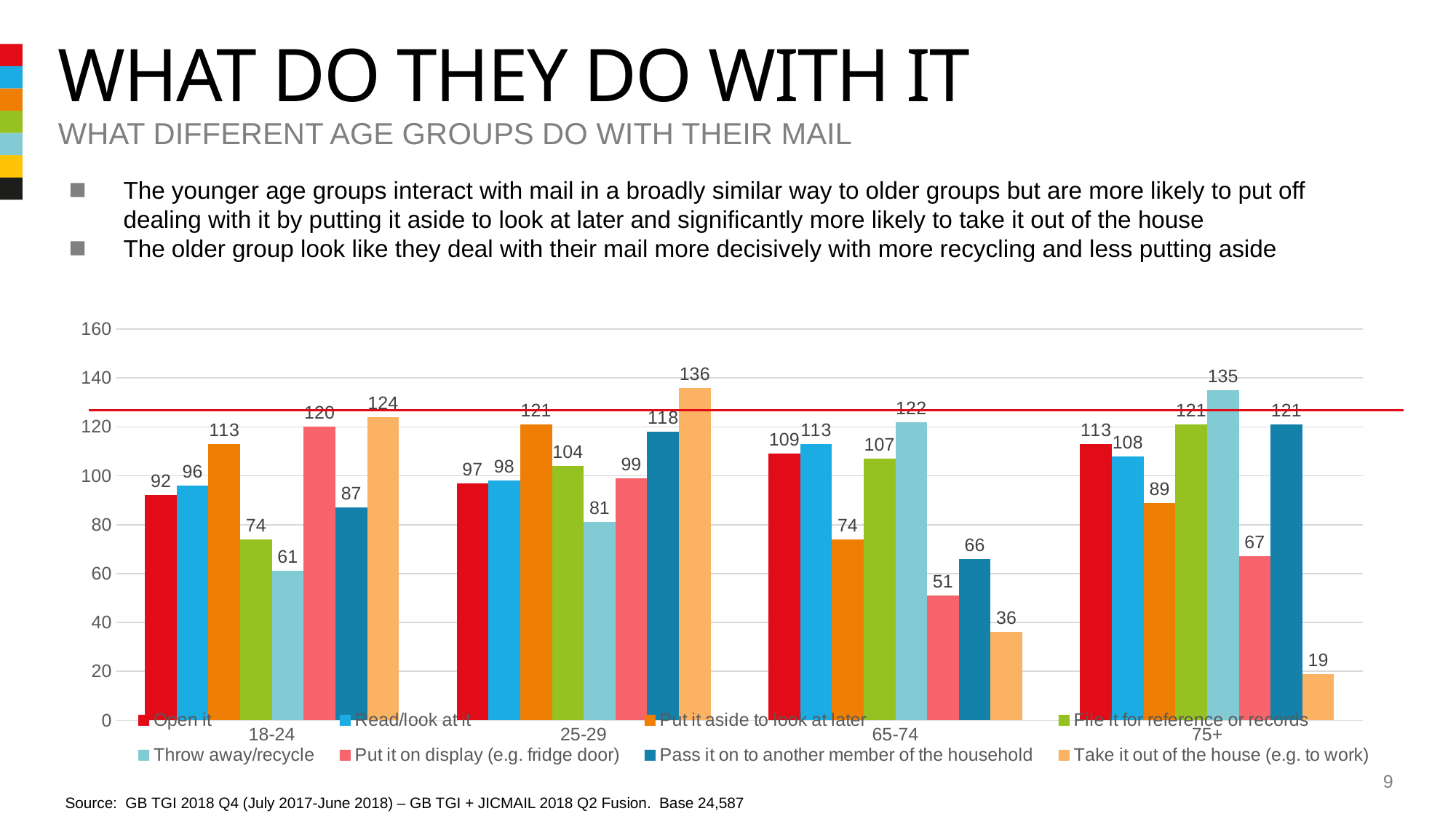
What is the subtitle of the chart slide? WHAT DIFFERENT AGE GROUPS DO WITH THEIR MAIL Which age group has the lowest value for 'Take it out of the house (e.g. to work)'? 75+ What is the value for 'Throw away/recycle' in the 75+ age group? 135 What is the value for 'Take it out of the house (e.g. to work)' in the 25-29 age group? 136 Which age group has the highest value for 'Throw away/recycle'? 75+ What is the difference between the 'Take it out of the house (e.g. to work)' values for 25-29 and 75+? 117 What kind of chart is shown on the slide? Bar chart Which is larger: 'Put it aside to look at later' for 18-24 or for 65-74? 18-24 How many series does the legend list? 8 What is the value for 'Put it on display (e.g. fridge door)' in the 18-24 age group? 120 How many age groups are shown on the x axis? 4 Does the value for 'Put it on display (e.g. fridge door)' rise or fall from 18-24 to 75+? Fall